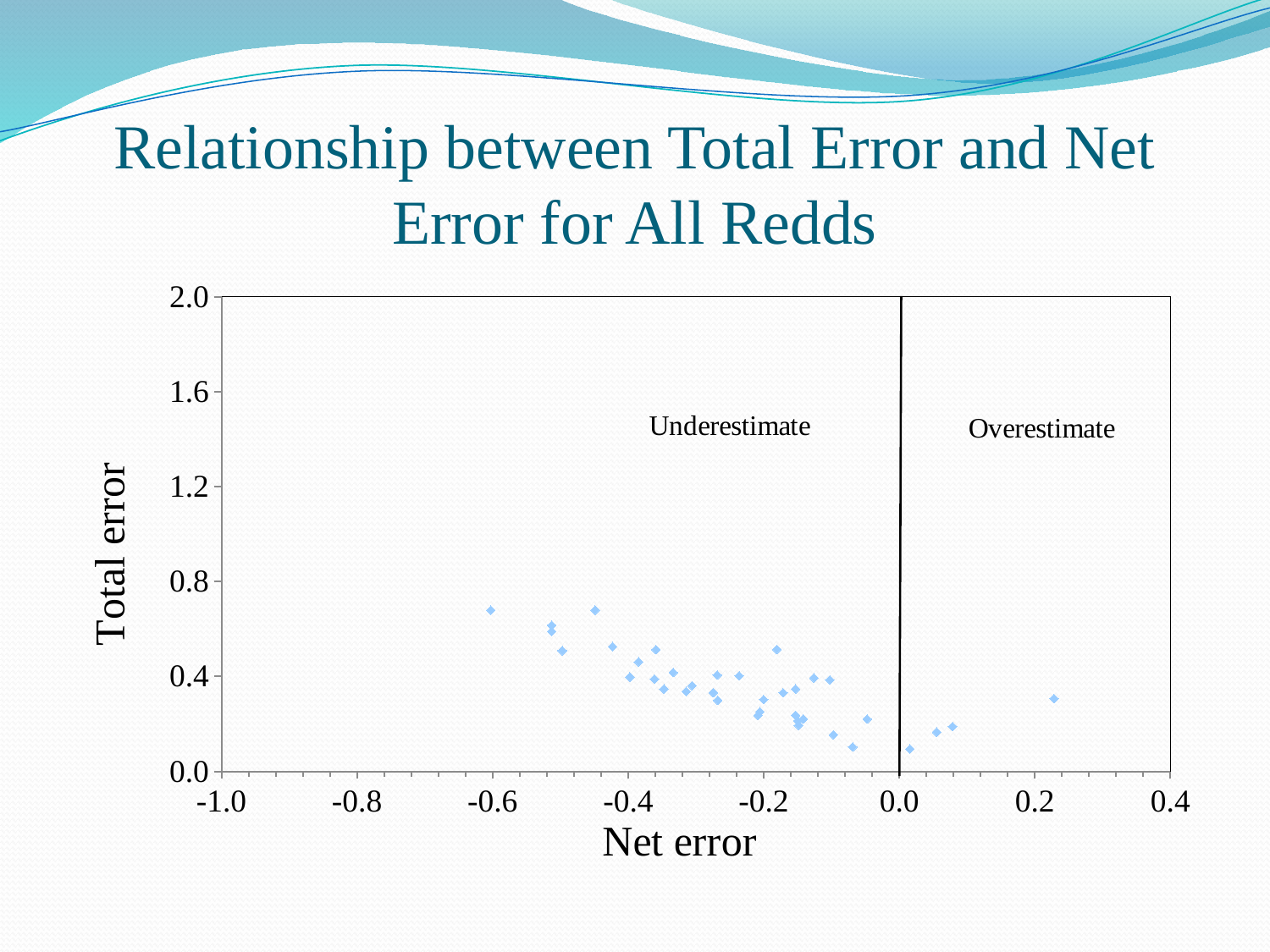
Is the net error of the rightmost point greater or less than 0.4? less What label is on the vertical axis of the chart? Total error What is the title of the chart? Relationship between Total Error and Net Error for All Redds Is the net error of the rightmost point greater or less than 0.0? greater Is the highest total error plotted greater or less than 0.8? less How many points lie in the Overestimate region (to the right of the vertical line at net error 0.0)? 4 What kind of chart is shown on the slide? scatter plot What is the maximum value shown on the Total error axis? 2.0 As net error increases from -0.6 toward 0.0, does total error generally rise or fall? fall Are there more points in the Underestimate region or the Overestimate region? Underestimate